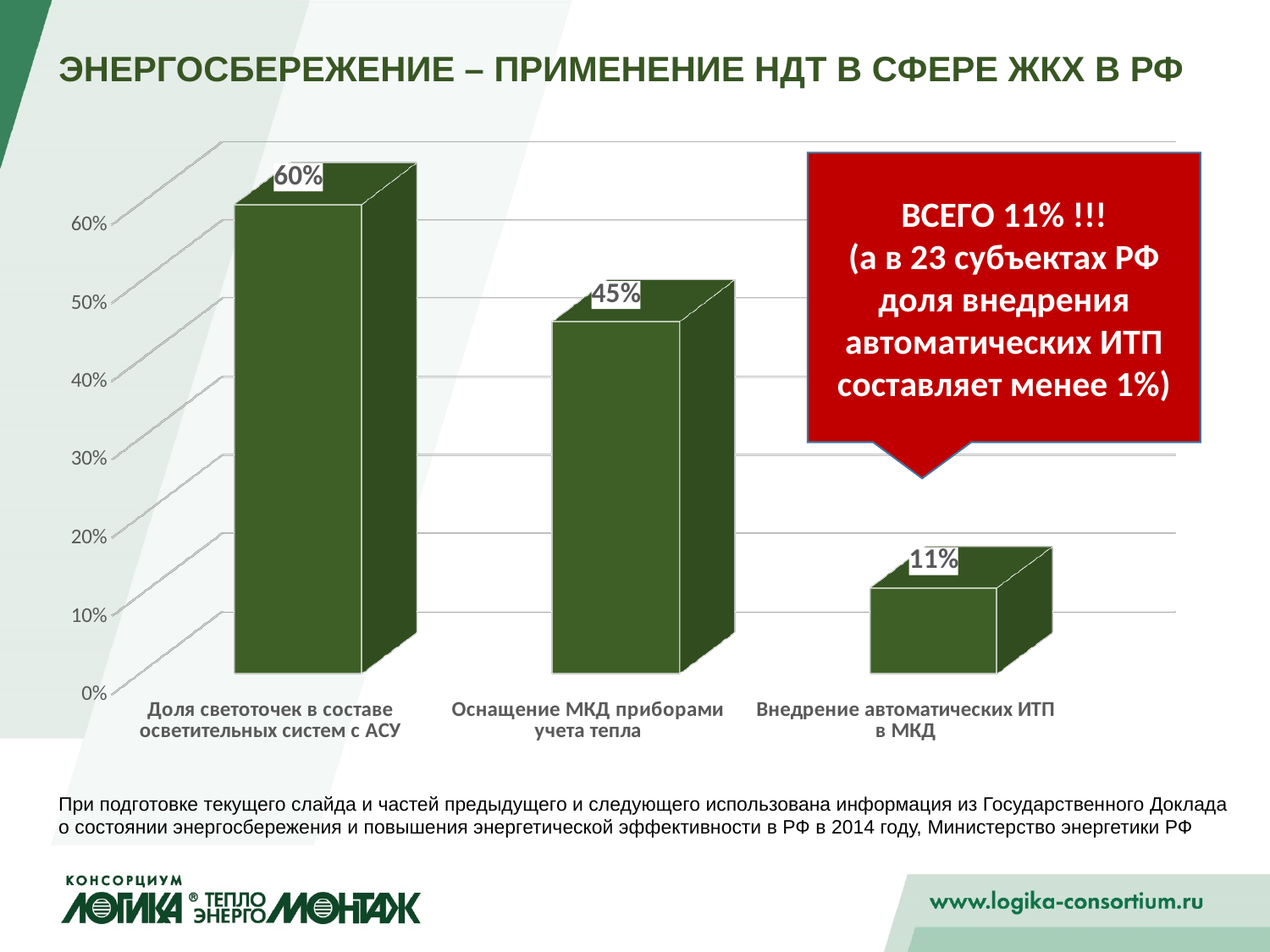
Which category has the highest value? Доля светоточек в составе осветительных систем с АСУ What is the value for "Оснащение МКД приборами учета тепла"? 45% Do the values rise or fall from left to right along the x axis? fall What is the value for "Доля светоточек в составе осветительных систем с АСУ"? 60% How many categories are shown in the chart? 3 What is the value for "Внедрение автоматических ИТП в МКД"? 11% Which category has the lowest value? Внедрение автоматических ИТП в МКД What is the difference between the values for "Оснащение МКД приборами учета тепла" and "Внедрение автоматических ИТП в МКД"? 34% What kind of chart is shown on the slide? bar chart What is the difference between the values for "Доля светоточек в составе осветительных систем с АСУ" and "Оснащение МКД приборами учета тепла"? 15% Which is larger: the value for "Оснащение МКД приборами учета тепла" or for "Внедрение автоматических ИТП в МКД"? Оснащение МКД приборами учета тепла Is the value for "Оснащение МКД приборами учета тепла" greater or less than 40%? greater